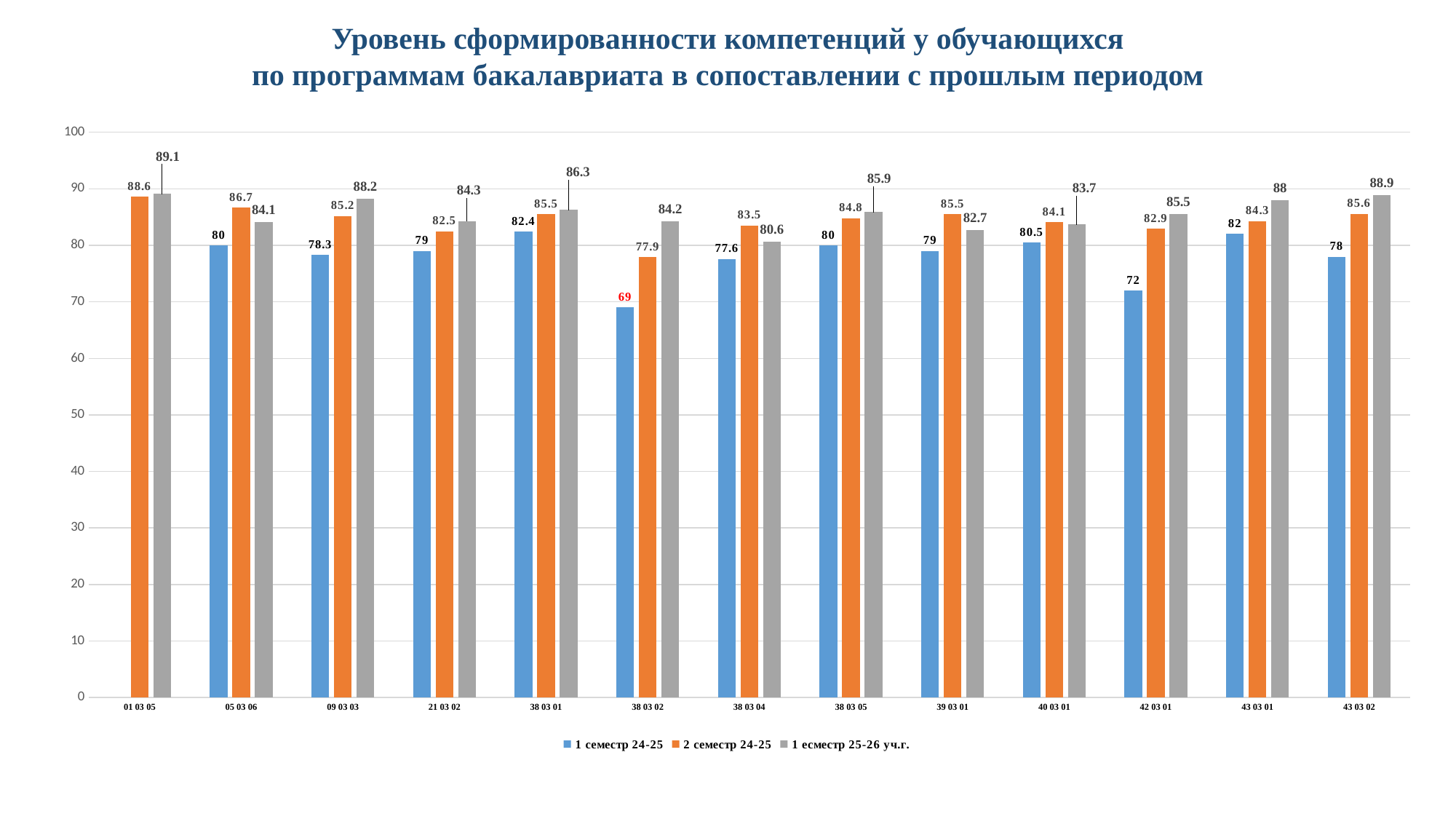
Which category has the highest value for 2 семестр 24-25? 01 03 05 Which data label on the chart is printed in red? 69 How many categories are shown on the x axis? 13 Which category has the highest value for 1 есместр 25-26 уч.г.? 01 03 05 In category 38 03 04, which series has the larger value: 2 семестр 24-25 or 1 есместр 25-26 уч.г.? 2 семестр 24-25 What kind of chart is shown on the slide? Bar chart What is the value for 1 семестр 24-25 in category 42 03 01? 72 What is the value for 1 есместр 25-26 уч.г. in category 43 03 02? 88.9 In category 38 03 02, what is the difference between the 1 есместр 25-26 уч.г. value and the 1 семестр 24-25 value? 15.2 How many series does the legend list? 3 What is the value for 2 семестр 24-25 in category 38 03 02? 77.9 Which category has the lowest value for 1 семестр 24-25? 38 03 02